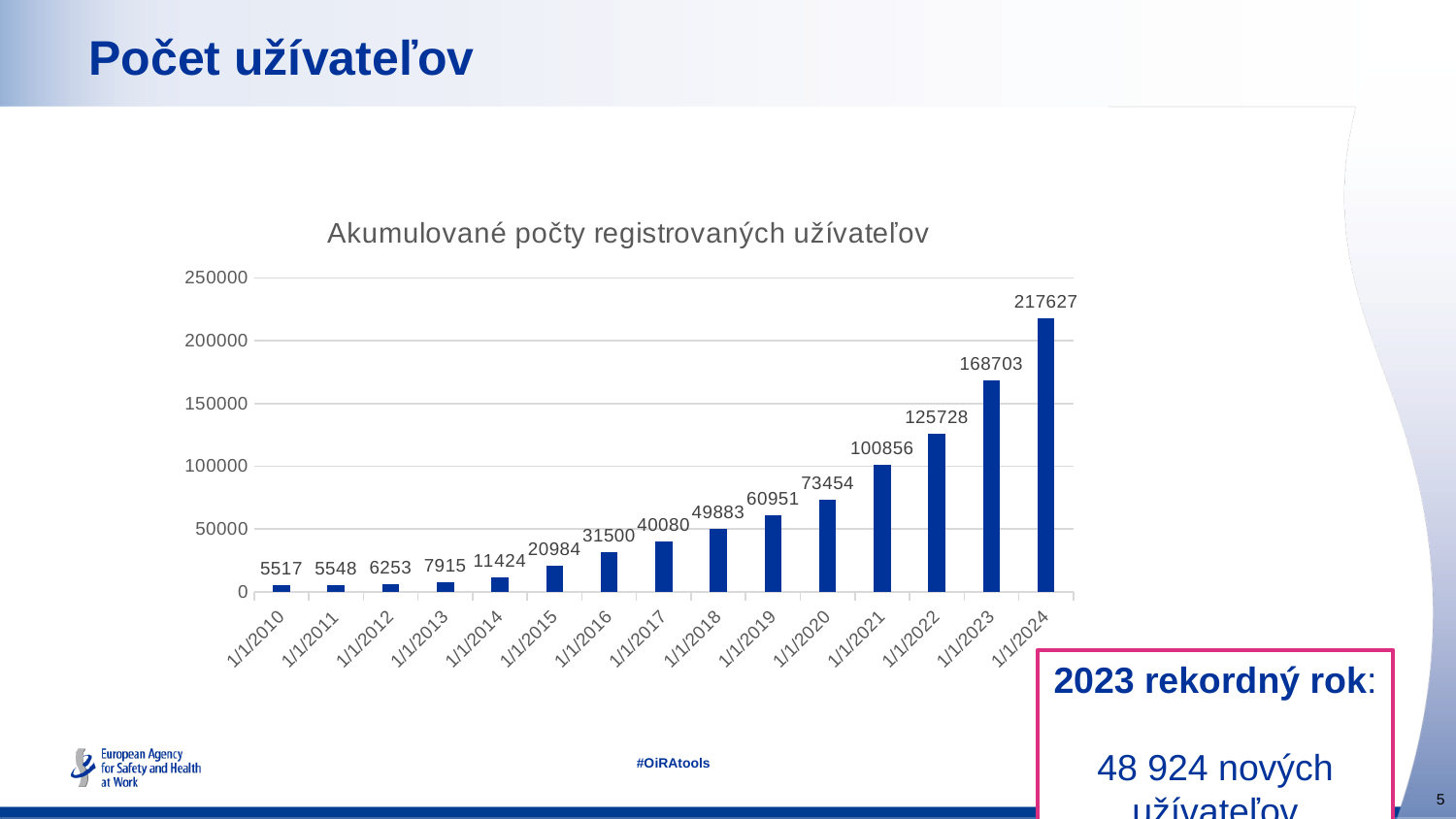
What is the value for 1/1/2015 in the chart? 20984 What is the difference between the values for 1/1/2024 and 1/1/2023? 48924 What is the difference between the values for 1/1/2022 and 1/1/2021? 24872 What is the value for 1/1/2024 in the chart? 217627 Which category has the lowest value in the chart? 1/1/2010 What kind of chart is shown on the slide? bar chart Is the value for 1/1/2023 greater or less than 150000? greater Do the values rise or fall from 1/1/2010 to 1/1/2024? rise What is the value for 1/1/2021 in the chart? 100856 How many categories are shown on the x axis of the chart? 15 Which category has the highest value in the chart? 1/1/2024 Which is larger, the value for 1/1/2019 or the value for 1/1/2018? 1/1/2019